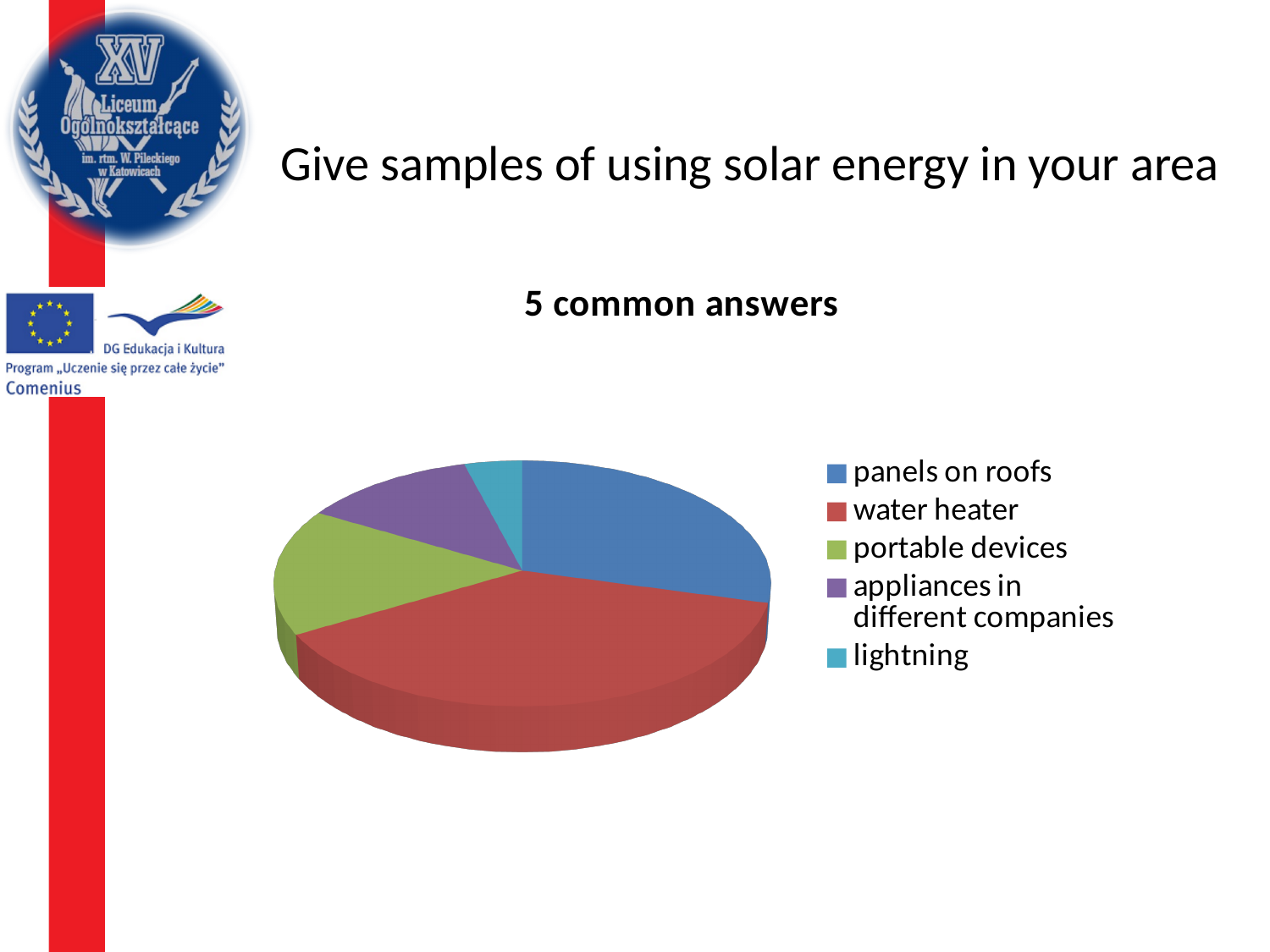
Which category has the largest slice of the pie chart? water heater How many categories does the pie chart show? 5 Which slice is larger: appliances in different companies or lightning? appliances in different companies What is the title of the chart? 5 common answers Which category has the smallest slice of the pie chart? lightning Which slice is larger: water heater or panels on roofs? water heater Which slice is larger: panels on roofs or portable devices? panels on roofs What colour is the slice for water heater in the pie chart? red What kind of chart is shown on the slide? pie chart How many entries does the legend of the pie chart list? 5